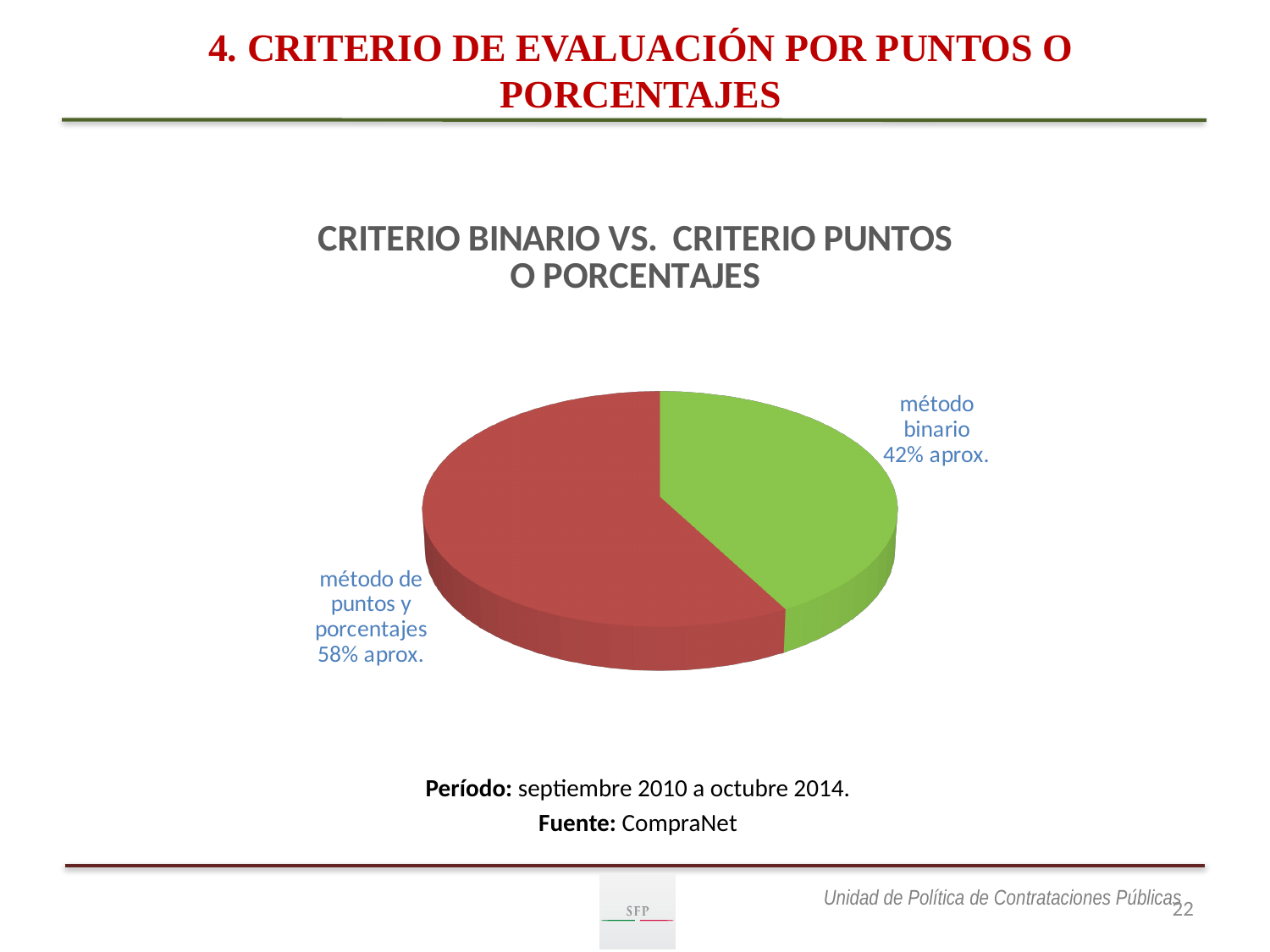
What share of the pie is labelled for "método de puntos y porcentajes"? 58% aprox. What colour is the slice for "método binario"? green What is the title of the chart? CRITERIO BINARIO VS. CRITERIO PUNTOS O PORCENTAJES How many slices does the pie chart have? 2 What share of the pie is labelled for "método binario"? 42% aprox. What kind of chart is shown on the slide? pie chart Which is larger, the slice for "método binario" or the slice for "método de puntos y porcentajes"? método de puntos y porcentajes Is the share for "método de puntos y porcentajes" greater or less than 50%? greater Which slice of the pie is the largest? método de puntos y porcentajes Which slice of the pie is the smallest? método binario Is the share for "método binario" greater or less than 50%? less